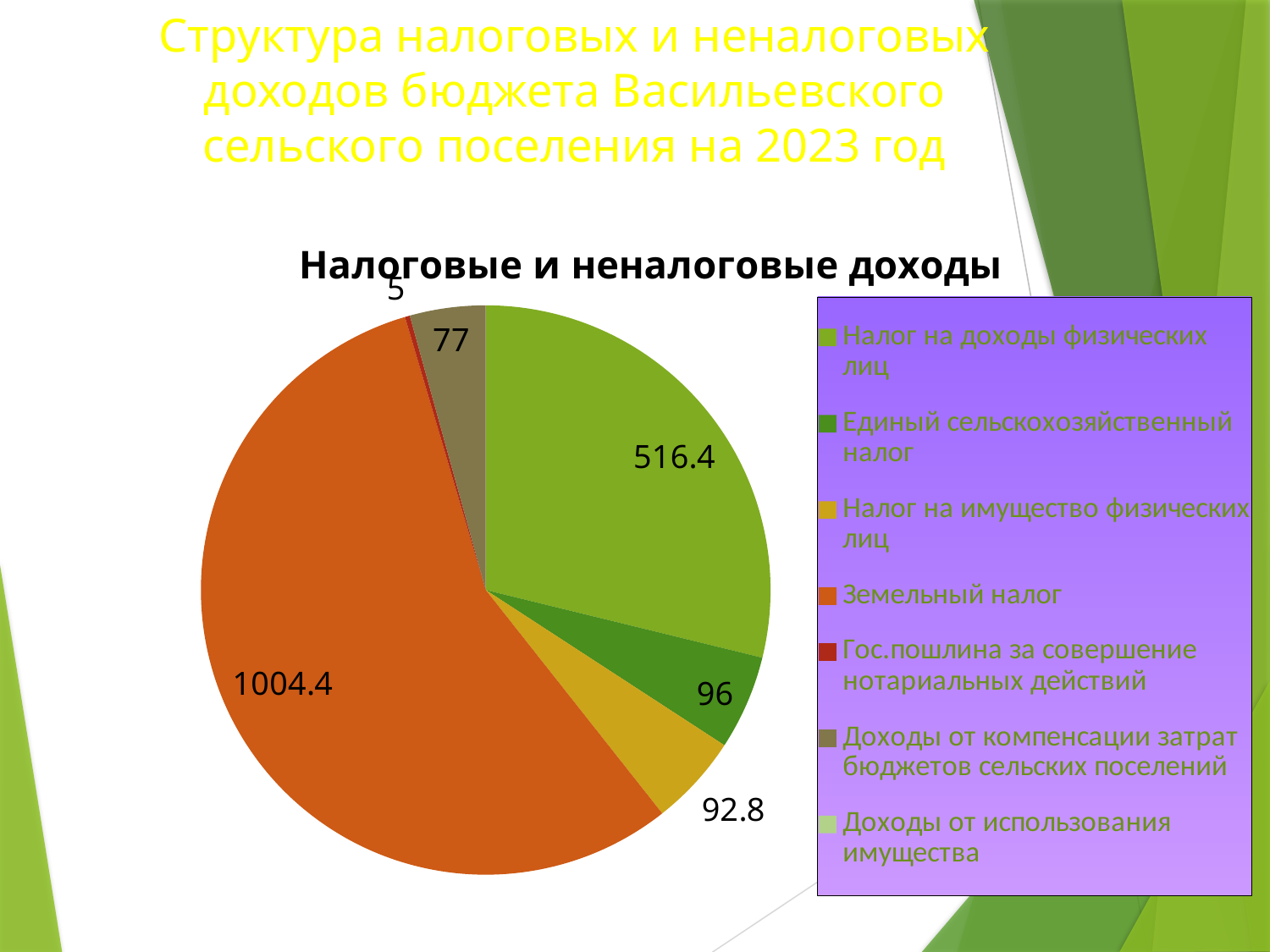
What is the value for Гос.пошлина за совершение нотариальных действий? 5 Which category has the largest slice of the pie? Земельный налог How many entries does the legend list? 7 What type of chart is shown on the slide? pie chart What is the value for Налог на имущество физических лиц? 92.8 What is the value for Единый сельскохозяйственный налог? 96 What is the value for Доходы от компенсации затрат бюджетов сельских поселений? 77 What is the title of the chart? Налоговые и неналоговые доходы What is the difference between the values for Земельный налог and Налог на доходы физических лиц? 488 What is the value for Налог на доходы физических лиц? 516.4 Which is larger: Единый сельскохозяйственный налог or Налог на имущество физических лиц? Единый сельскохозяйственный налог What is the value for Земельный налог? 1004.4